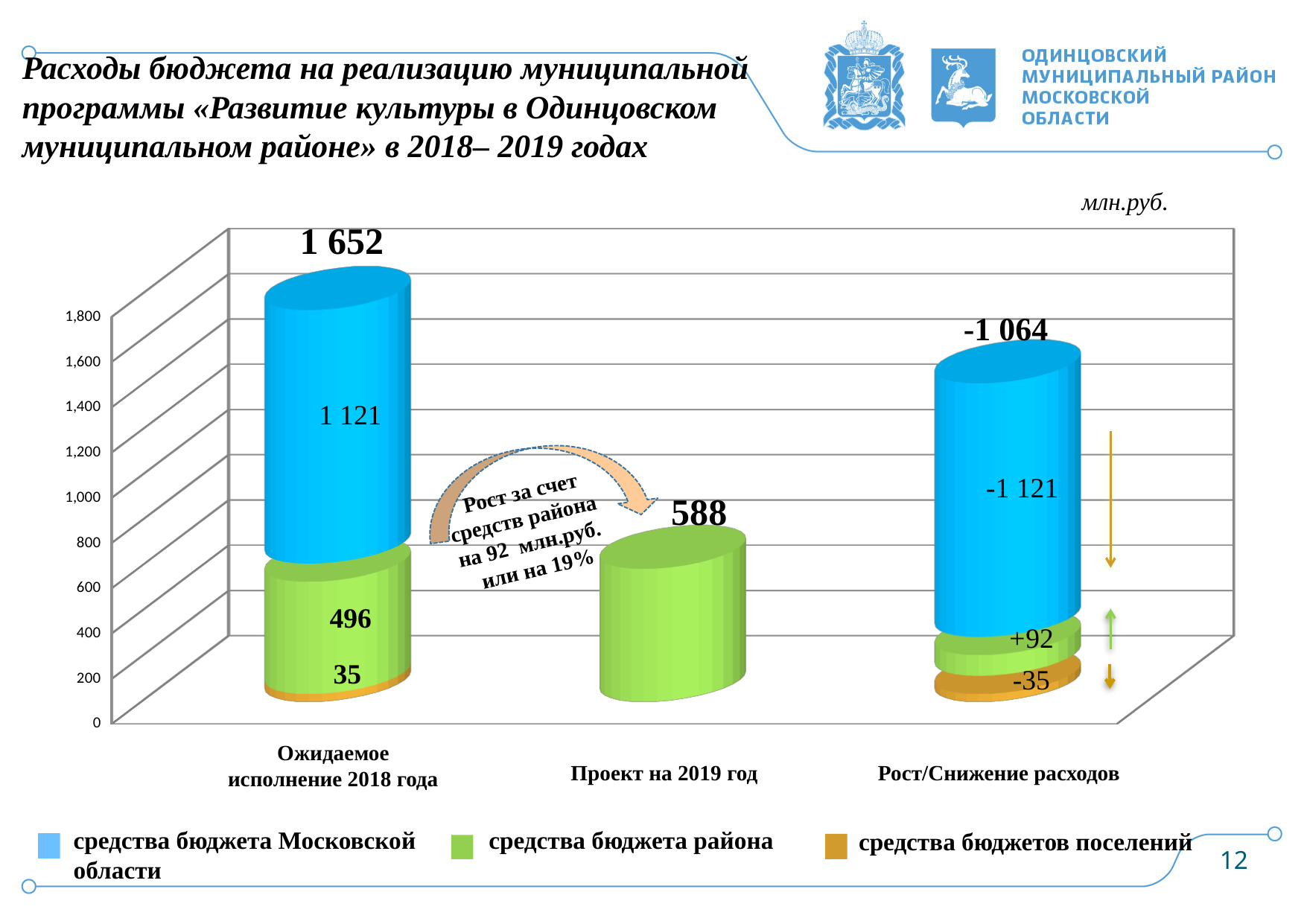
What is the value of "средства бюджета Московской области" for "Ожидаемое исполнение 2018 года"? 1 121 How many categories are shown on the x axis of the chart? 3 How many series does the legend list? 3 What is the difference between "средства бюджета района" for "Проект на 2019 год" and for "Ожидаемое исполнение 2018 года"? 92 What is the value shown for "Проект на 2019 год"? 588 What is the value of "средства бюджетов поселений" for "Ожидаемое исполнение 2018 года"? 35 Which is larger for "Ожидаемое исполнение 2018 года": "средства бюджета Московской области" or "средства бюджета района"? средства бюджета Московской области What is the total value shown above the bar for "Рост/Снижение расходов"? -1 064 What is the total value shown above the bar for "Ожидаемое исполнение 2018 года"? 1 652 What type of chart is shown on the slide? bar chart What is the value of "средства бюджета района" for "Рост/Снижение расходов"? +92 What is the value of "средства бюджета района" for "Ожидаемое исполнение 2018 года"? 496